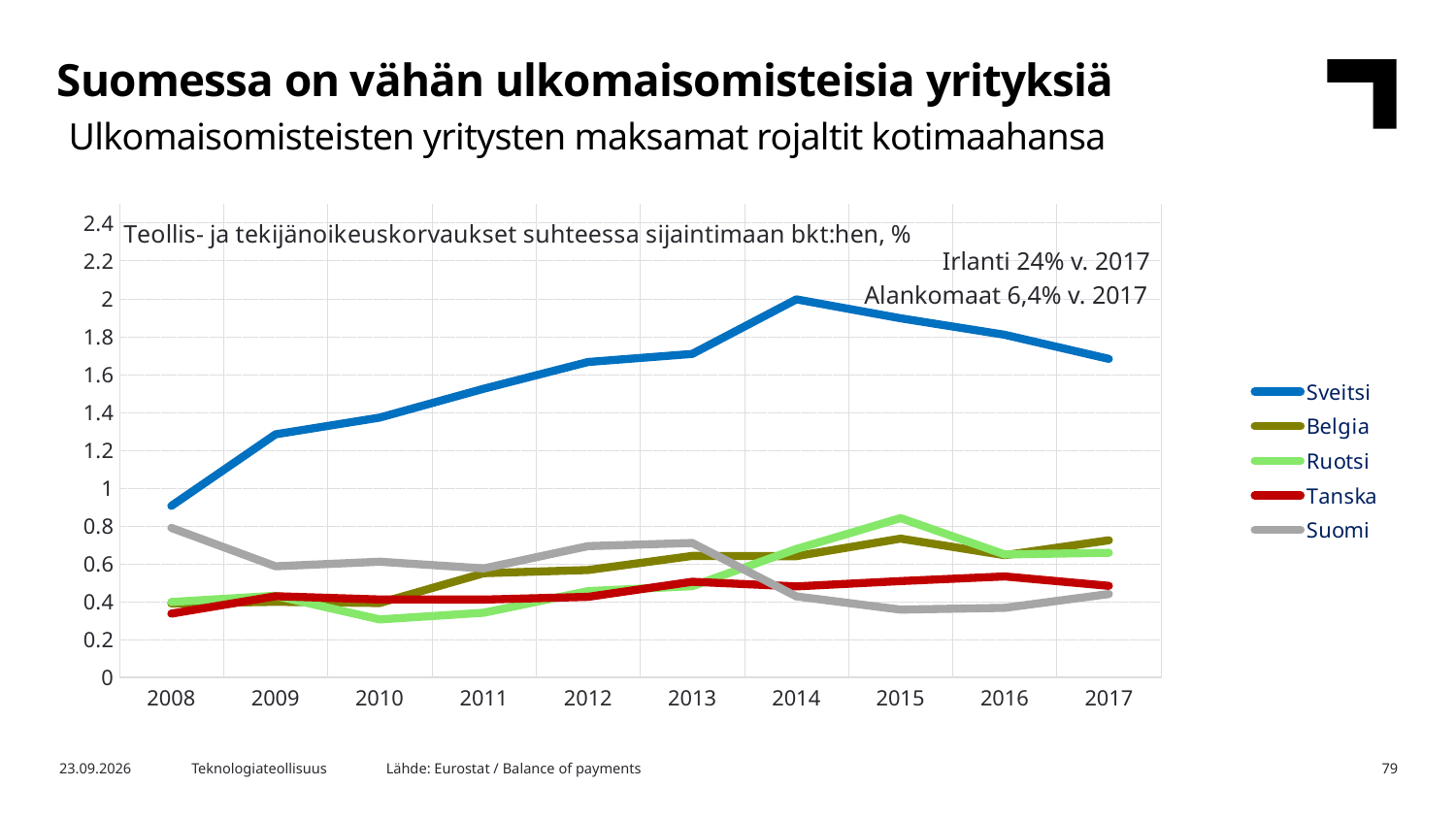
Which series has the highest value in 2017? Sveitsi Does the Sveitsi line rise or fall from 2008 to 2014? rise What value is given for Irlanti in the annotation on the chart? 24% v. 2017 Is the value for Suomi in 2008 greater or less than 0.6? greater Which series has the lowest value in 2015? Suomi How many years are shown on the x axis? 10 Is the value for Sveitsi in 2008 greater or less than 1? less Does the Sveitsi line rise or fall from 2014 to 2017? fall How many series does the legend list? 5 In 2017, which is larger: the value for Belgia or the value for Suomi? Belgia Is the value for Sveitsi in 2014 greater or less than 1.8? greater What kind of chart is shown on the slide? line chart